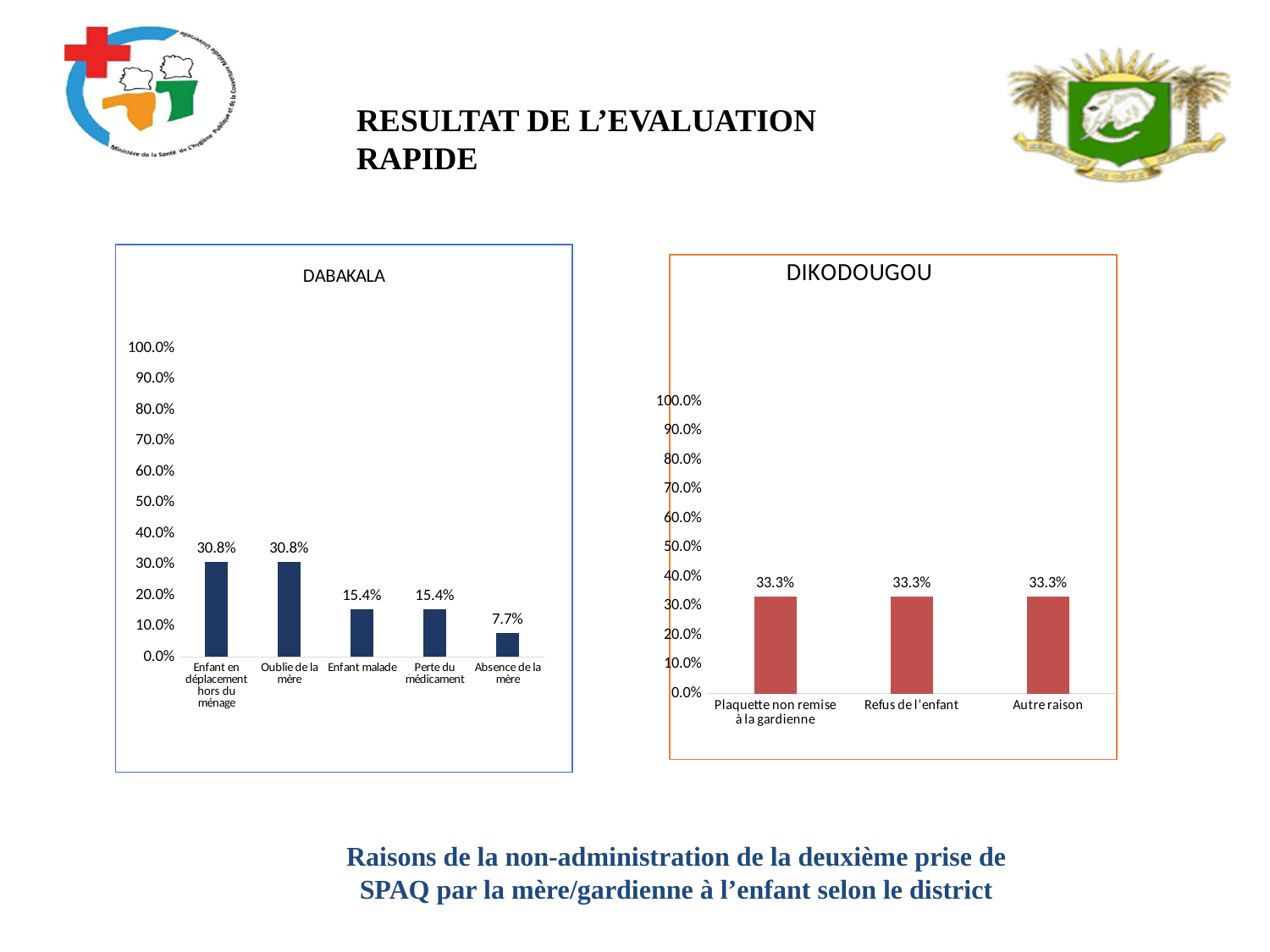
In the DIKODOUGOU chart, what is the value for Refus de l'enfant? 33.3% What type of chart is the DIKODOUGOU chart? Bar chart How many categories are shown in the DIKODOUGOU chart? 3 In the DABAKALA chart, what is the value for Oublie de la mère? 30.8% In the DABAKALA chart, which is larger: Enfant malade or Absence de la mère? Enfant malade In the DIKODOUGOU chart, is the value for Autre raison greater or less than 50.0%? less In the DABAKALA chart, what is the value for Absence de la mère? 7.7% In the DABAKALA chart, what is the value for Enfant malade? 15.4% In the DABAKALA chart, what is the difference between Enfant en déplacement hors du ménage and Perte du médicament? 15.4% What colour are the bars in the DIKODOUGOU chart? Red In the DABAKALA chart, which category has the lowest value? Absence de la mère How many categories are shown in the DABAKALA chart? 5